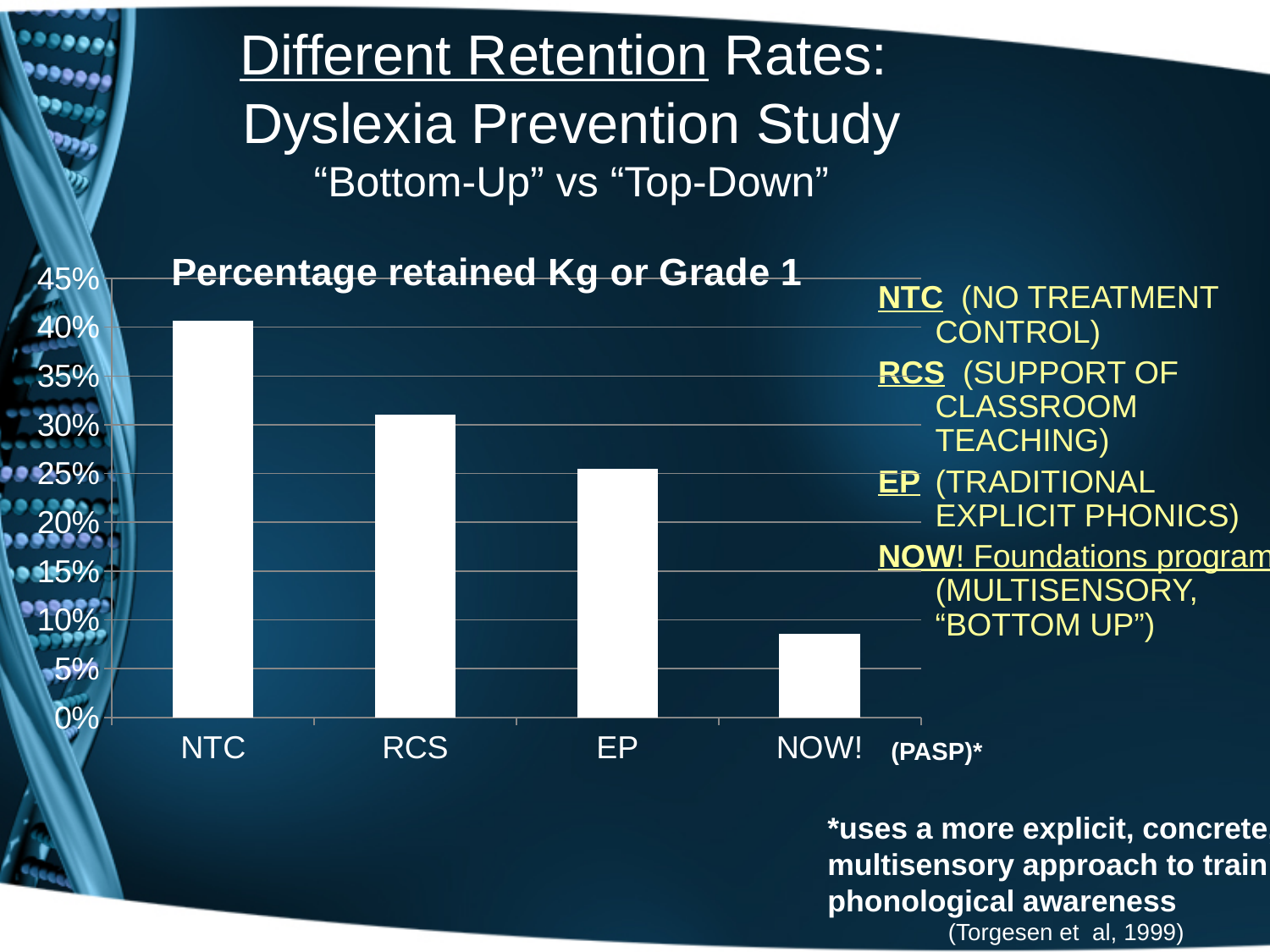
Which category has the highest percentage retained? NTC Which category has the lowest percentage retained? NOW! Do the bar values rise or fall from left to right across the categories? fall Is the value for NTC greater or less than 35%? greater How many categories are plotted in the chart? 4 Which has a lower percentage retained, EP or NOW!? NOW! Is the value for NOW! greater or less than 15%? less What kind of chart is shown on the slide? bar chart Which has a higher percentage retained, NTC or RCS? NTC What is the title of the chart? Percentage retained Kg or Grade 1 Is the value for RCS greater or less than 25%? greater